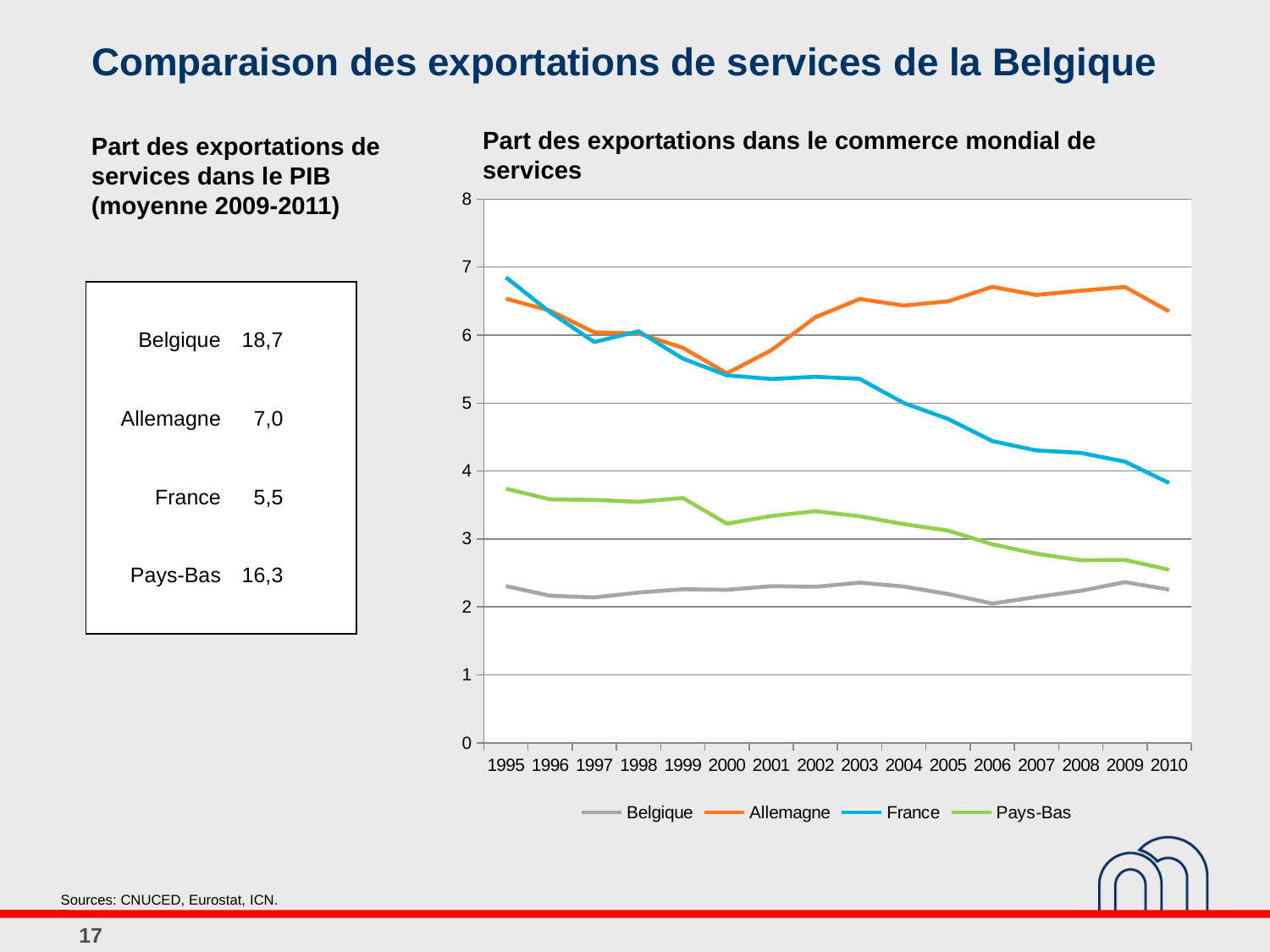
In the chart 'Part des exportations dans le commerce mondial de services', which series has the lowest value in 2010? Belgique In the chart 'Part des exportations dans le commerce mondial de services', is the value for Pays-Bas in 2010 greater or less than 3? less In the chart 'Part des exportations dans le commerce mondial de services', does the France line rise or fall from 1995 to 2010? fall How many series does the legend of the chart 'Part des exportations dans le commerce mondial de services' list? 4 In the chart 'Part des exportations dans le commerce mondial de services', is the value for France in 2010 greater or less than 4? less In the chart 'Part des exportations dans le commerce mondial de services', is the value for Allemagne in 2006 greater or less than 6? greater In the chart 'Part des exportations dans le commerce mondial de services', which series has the highest value in 2010? Allemagne In the chart 'Part des exportations dans le commerce mondial de services', what colour is the France line? blue In the chart 'Part des exportations dans le commerce mondial de services', does the Pays-Bas line rise or fall from 1995 to 2010? fall What kind of chart is 'Part des exportations dans le commerce mondial de services'? line chart In the chart 'Part des exportations dans le commerce mondial de services', which is larger in 2000: Belgique or Pays-Bas? Pays-Bas How many years are shown on the x axis of the chart 'Part des exportations dans le commerce mondial de services'? 16